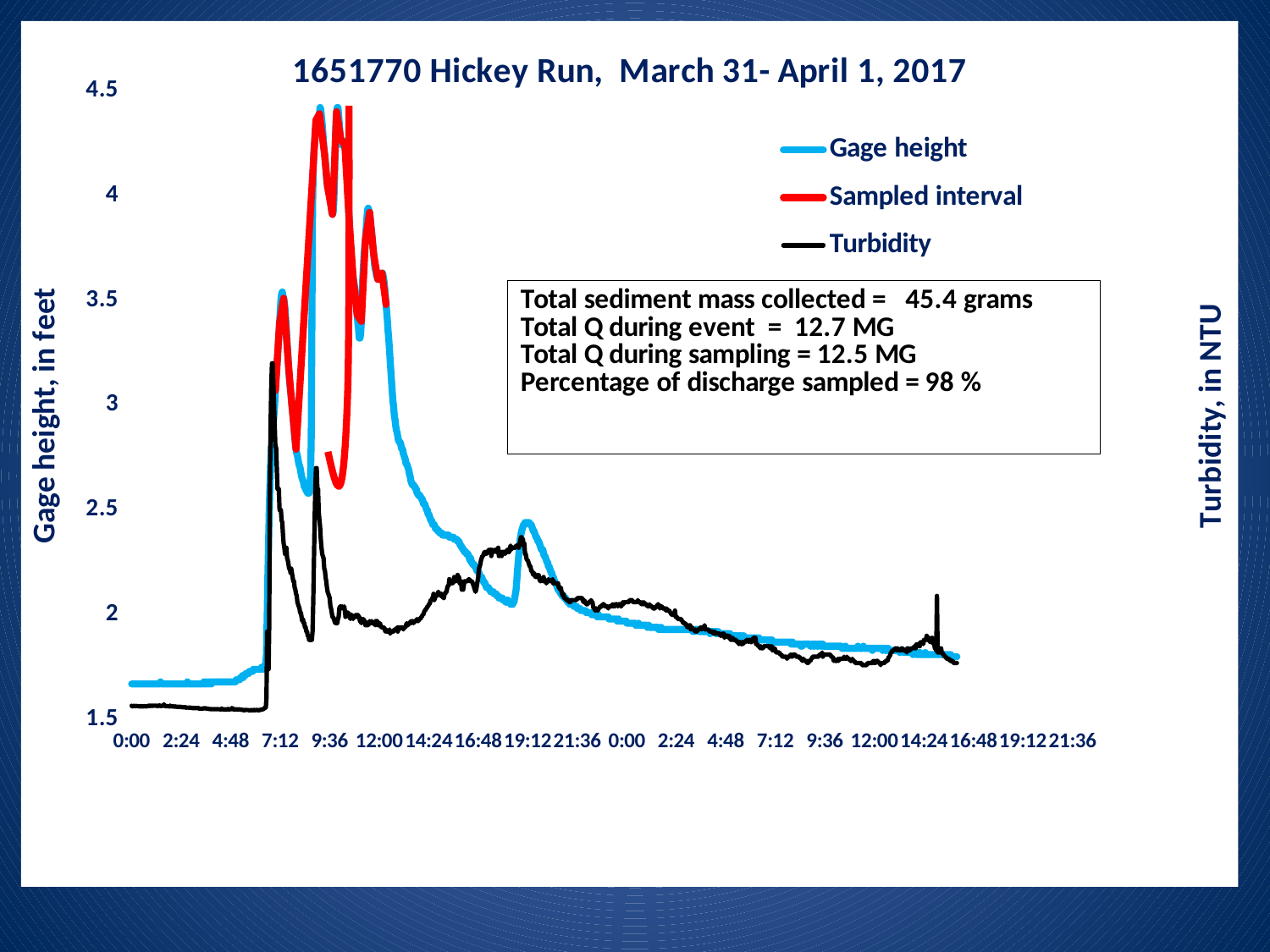
Is the peak gage height reached during the event greater or less than 4 feet? greater What is the total Q during sampling, as stated in the text box on the chart? 12.5 MG What is the total Q during the event, as stated in the text box on the chart? 12.7 MG Which series is drawn in red in the chart? Sampled interval Does the gage height rise or fall between 12:00 on the first day and 16:48 on the second day? fall What percentage of discharge was sampled, according to the text box on the chart? 98 % Is the gage height at the first 0:00 on the x axis greater or less than 2 feet? less Which is larger: the gage height at its peak near 9:36 on the first day, or the gage height at the first 0:00? The peak near 9:36 What is the title of the chart? 1651770 Hickey Run, March 31- April 1, 2017 What kind of chart is shown on the slide? Line chart How many series does the legend list? 3 What is the total sediment mass collected, as stated in the text box on the chart? 45.4 grams